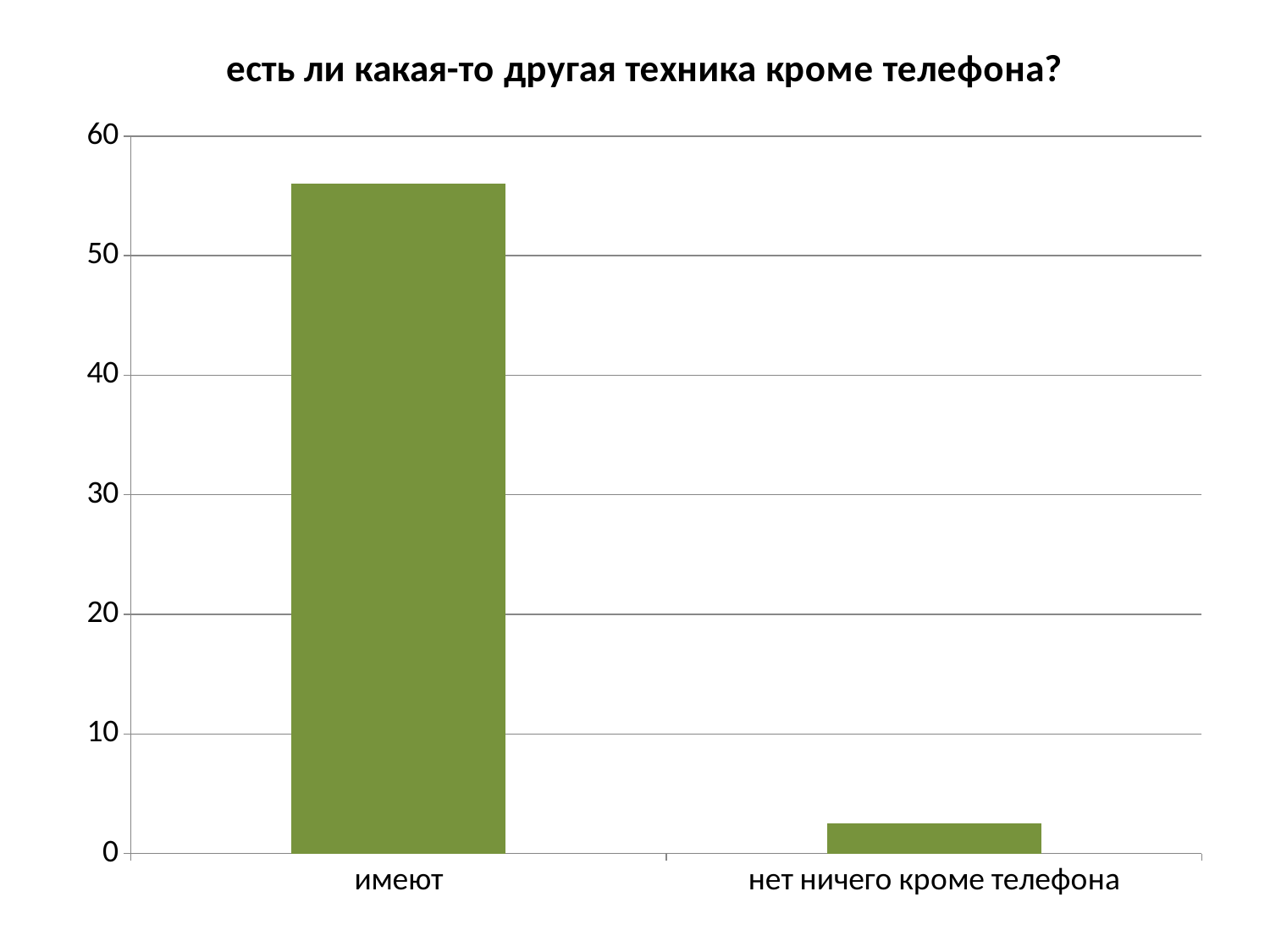
Is the value for "имеют" greater or less than 60? less Is the value for "имеют" greater or less than 50? greater Which category has the highest bar? имеют How many categories are shown on the x axis of the chart? 2 Is the value for "нет ничего кроме телефона" greater or less than 10? less What kind of chart is shown on the slide? bar chart What is the title of the chart? есть ли какая-то другая техника кроме телефона? What is the highest tick value shown on the vertical axis? 60 Which category has the lowest bar? нет ничего кроме телефона Do the bar values rise or fall from left to right along the x axis? fall Which is larger, the value for "имеют" or the value for "нет ничего кроме телефона"? имеют